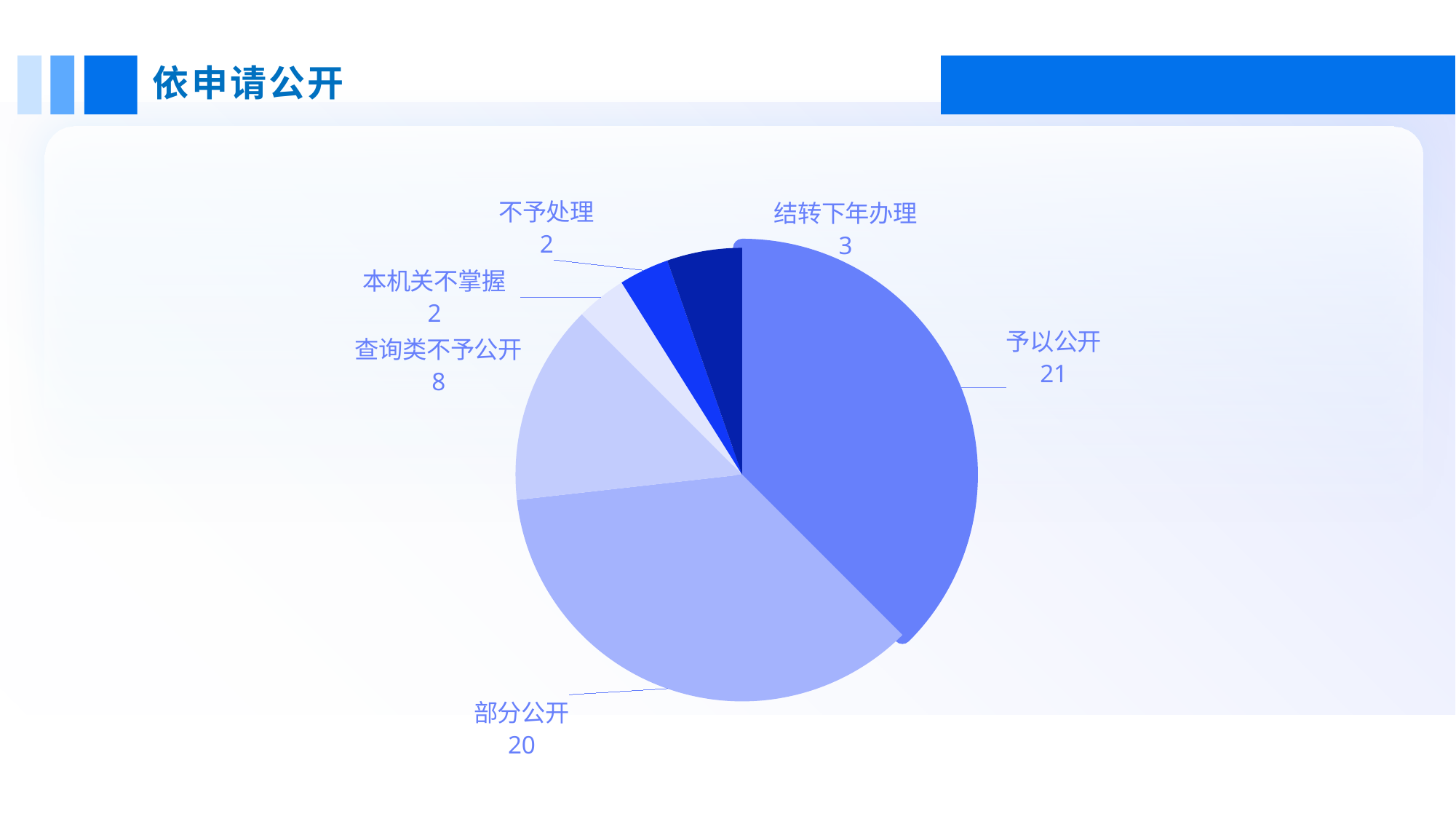
What is the value for 部分公开? 20 What is the value for 结转下年办理? 3 What is the value for 予以公开? 21 What kind of chart is shown on the slide? pie chart What is the title of the slide containing the chart? 依申请公开 Which is larger, the value for 查询类不予公开 or the value for 结转下年办理? 查询类不予公开 How many categories does the pie chart show? 6 What is the value for 查询类不予公开? 8 What is the total of all the slices in the pie chart? 56 Which category has the largest slice? 予以公开 What is the difference between the values for 查询类不予公开 and 结转下年办理? 5 What is the difference between the values for 予以公开 and 部分公开? 1